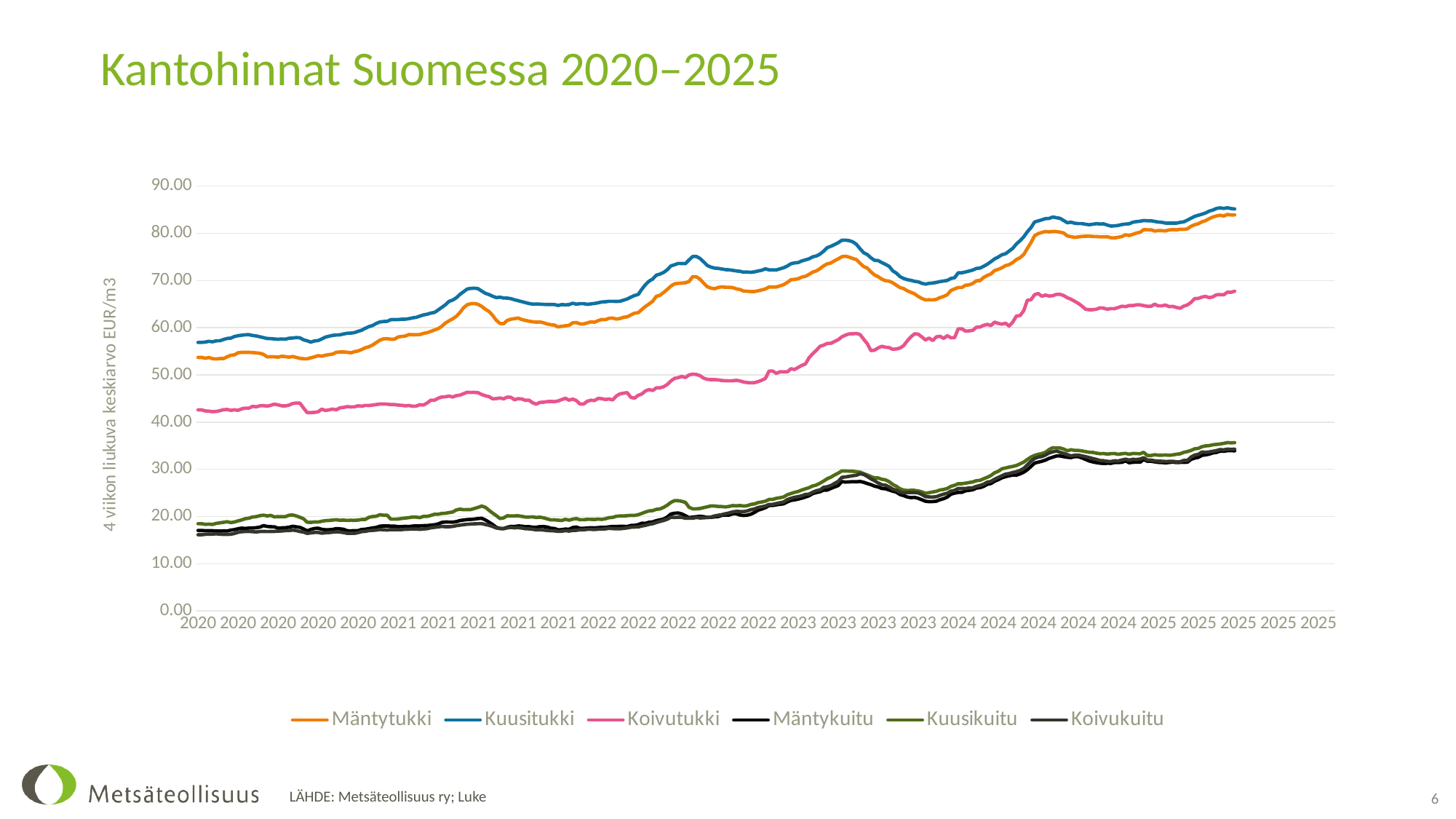
Does the Kuusitukki line rise or fall from 2020 to 2025? rises What is the label on the vertical axis? 4 viikon liukuva keskiarvo EUR/m3 Is the value for Koivutukki at the start of 2020 greater or less than 50? less Is the value for Koivutukki at the end of the series in 2025 greater or less than 60? greater What is the title of the chart? Kantohinnat Suomessa 2020–2025 Is the value for Kuusikuitu at the start of 2020 greater or less than 20? less How many series does the legend list? 6 Which series has the highest values across the chart? Kuusitukki In 2023, which is larger, Koivutukki or Mäntykuitu? Koivutukki What kind of chart is shown on the slide? line chart Does the Mäntykuitu line rise or fall from 2020 to 2025? rises